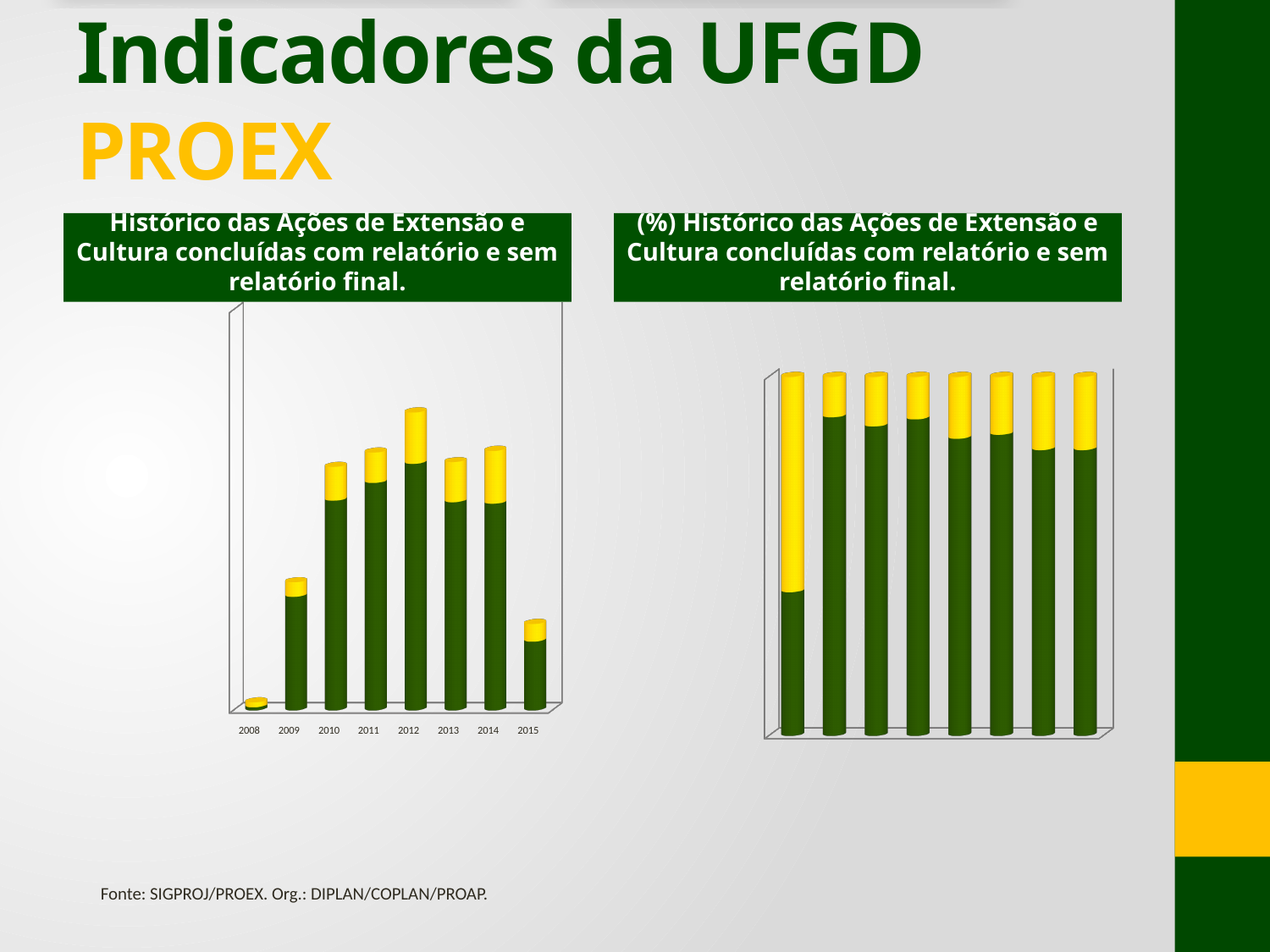
In the left chart, do the bars generally rise or fall from 2008 to 2012? Rise What two colours are used for the stacked segments in the left chart? Green and yellow In the left chart, how many years are shown on the x axis? 8 What kind of chart is the right chart, '(%) Histórico das Ações de Extensão e Cultura concluídas com relatório e sem relatório final.'? Stacked bar chart In the left chart, which year has the tallest bar? 2012 In the left chart, which year has the shortest bar? 2008 In the left chart, do the bars rise or fall from 2014 to 2015? Fall In the left chart, which bar is taller, 2012 or 2015? 2012 What is the first year shown on the x axis of the left chart? 2008 In the left chart, which bar is taller, 2009 or 2010? 2010 What kind of chart is the left chart, 'Histórico das Ações de Extensão e Cultura concluídas com relatório e sem relatório final.'? Stacked bar chart How many bars does the right chart show? 8